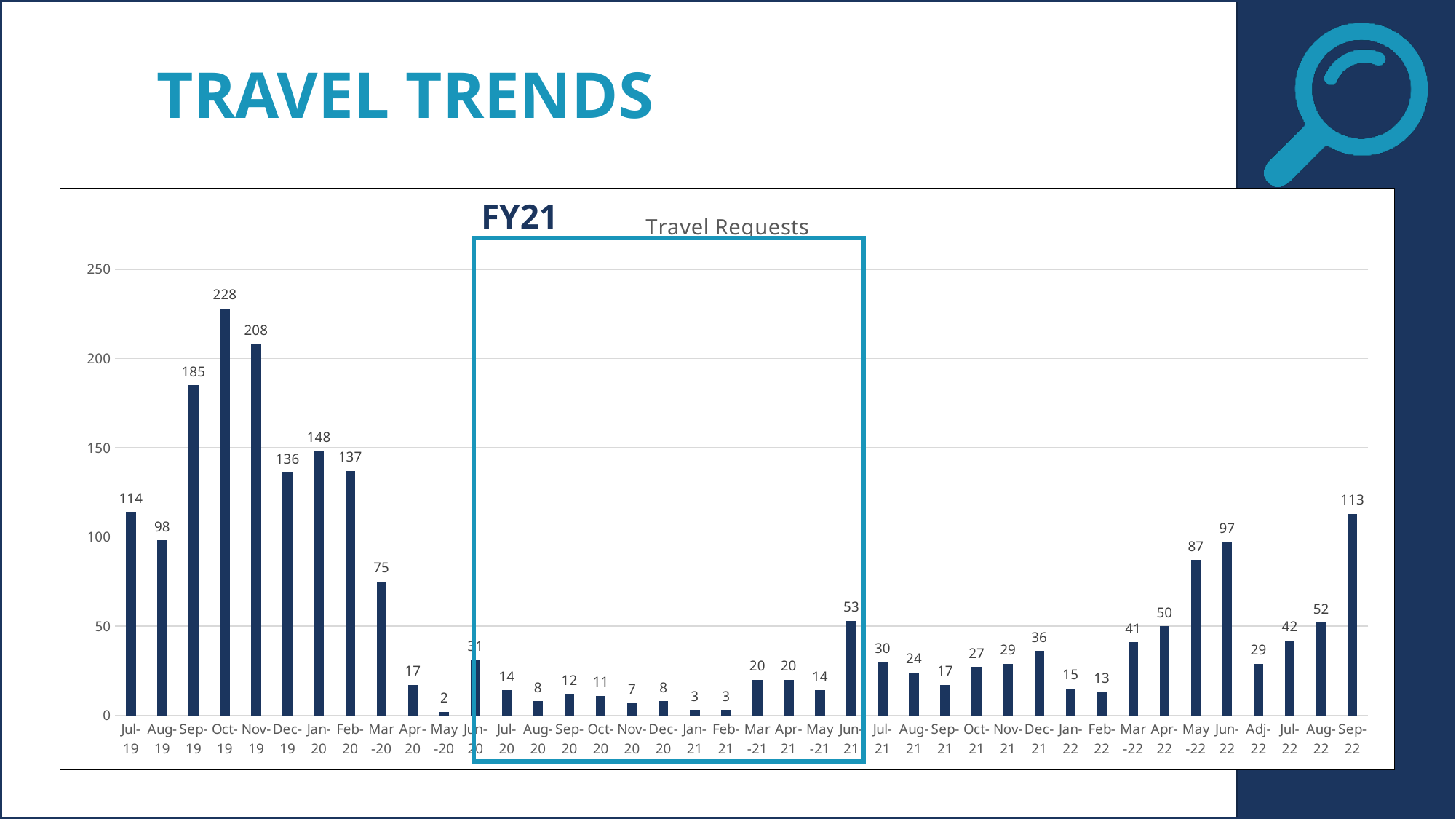
Which is larger, the value for May-22 or the value for Jun-22? Jun-22 What is the value for Sep-22? 113 Which fiscal year is highlighted by the box on the chart? FY21 What is the difference between the values for Oct-19 and Nov-19? 20 What is the value for Jun-21? 53 Which month has the lowest value? May-20 Do the values rise or fall from Jul-19 to Oct-19? They mostly rise (dip at Aug-19, then rise to Oct-19) Which month has the highest value? Oct-19 What is the title of the chart? Travel Requests Is the value for Sep-19 greater or less than 150? greater What is the value for Oct-19? 228 What kind of chart is shown on the slide? Bar chart